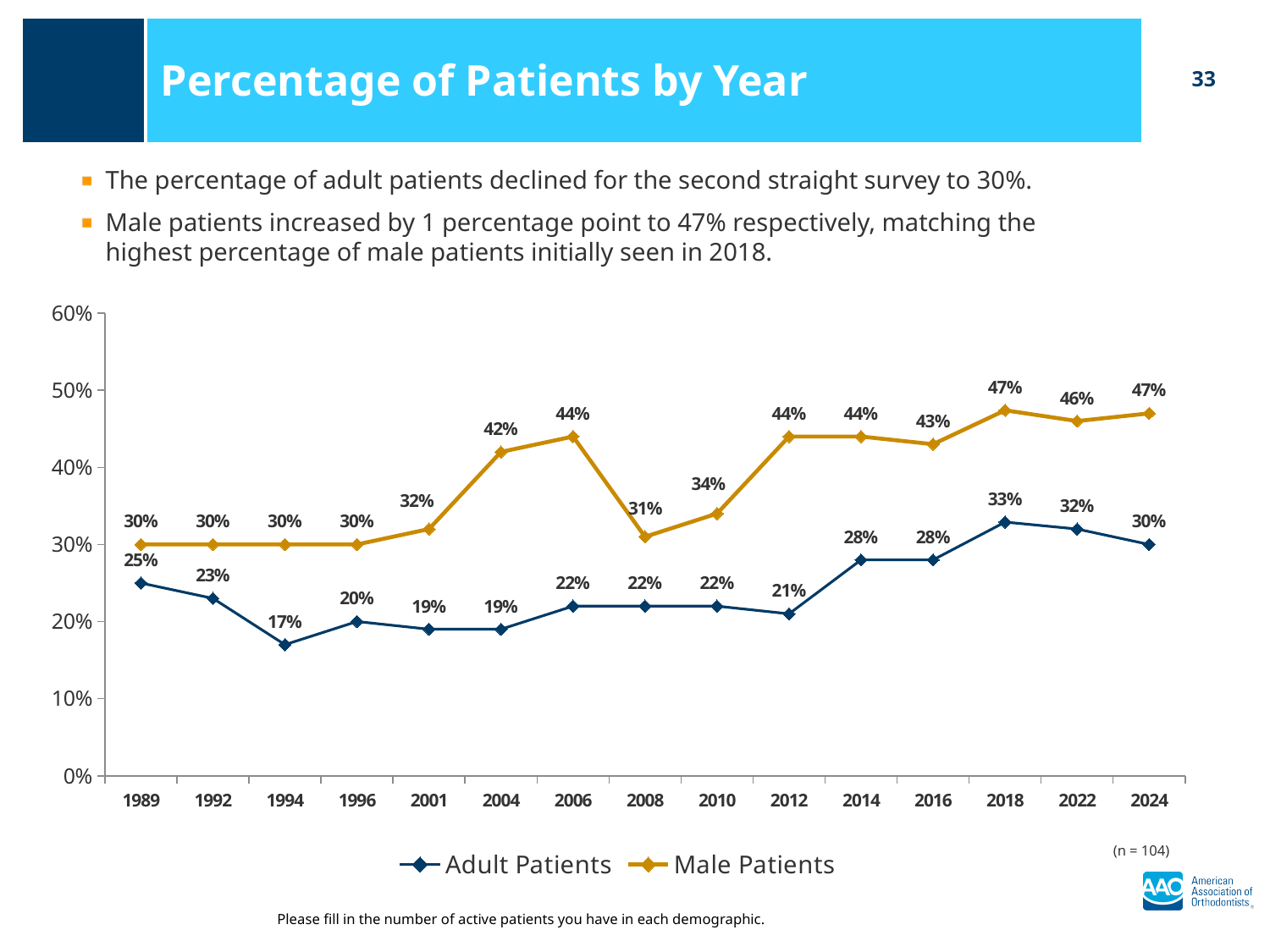
What kind of chart is shown on the slide? Line chart What is the value for Adult Patients in 2024? 30% In which year is the Adult Patients value lowest? 1994 What is the value for Male Patients in 2008? 31% How many years are shown on the x axis? 15 Did the Male Patients value rise or fall from 2018 to 2022? Fall How many series does the legend list? 2 What is the value for Adult Patients in 1994? 17% In which year is the Adult Patients value highest? 2018 What is the title of the slide containing the chart? Percentage of Patients by Year What is the difference between Male Patients and Adult Patients in 2006? 22% Which is larger in 2001: Male Patients or Adult Patients? Male Patients